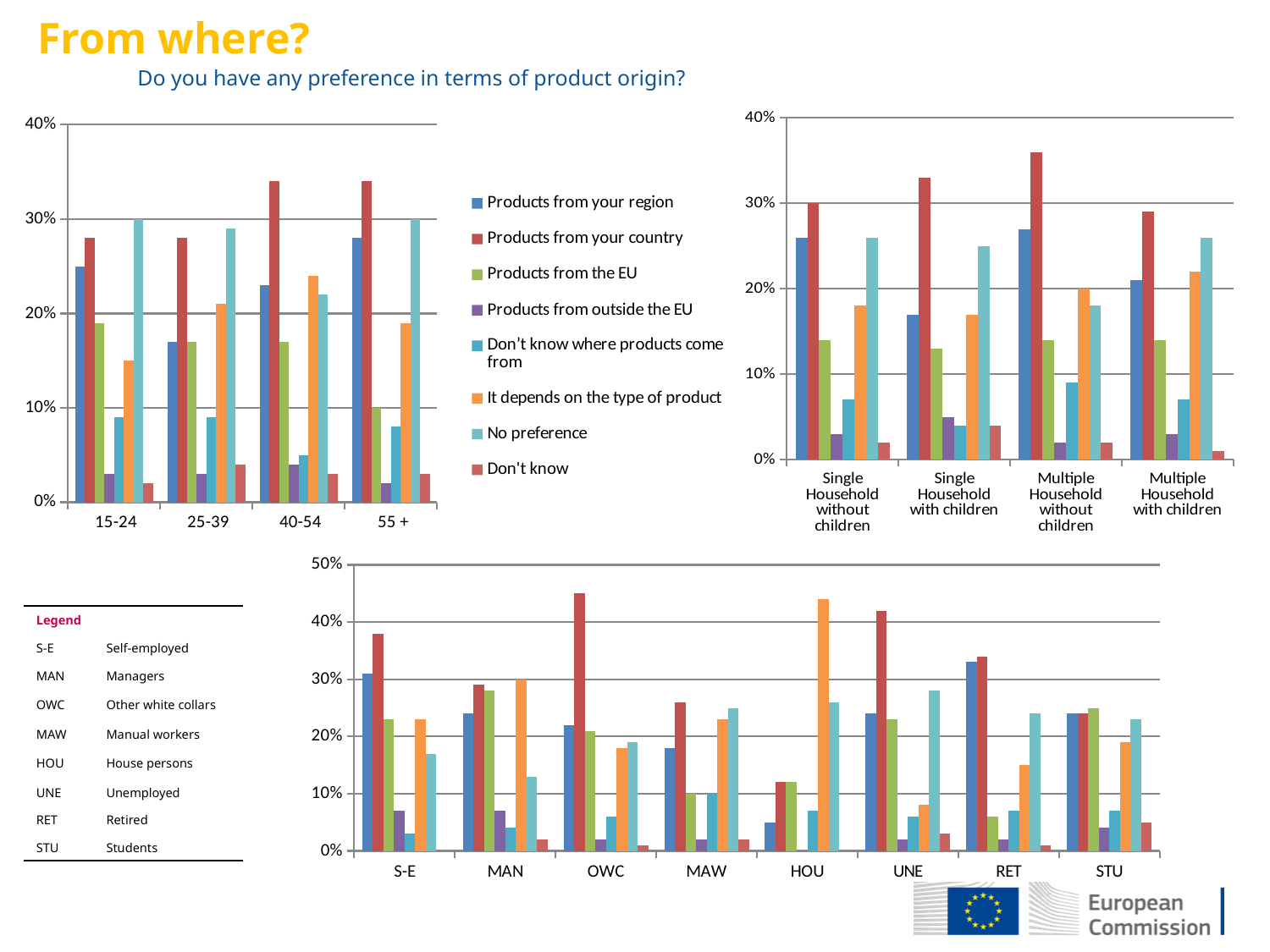
In the top-right household chart, which household type has the highest value for 'Products from your country'? Multiple Household without children In the bottom occupation chart, is the value for 'Products from your region' for HOU greater or less than 10%? less In the bottom occupation chart, which occupation has the highest value for 'Products from your country'? OWC How many household categories are shown on the x axis of the top-right chart? 4 According to the legend table on the slide, what does OWC stand for? Other white collars What kind of chart is the bottom chart with occupation categories (S-E, MAN, OWC, ...)? bar chart How many series does the legend in the middle of the slide list? 8 How many occupation categories are shown on the x axis of the bottom chart? 8 In the bottom occupation chart, is the value for 'It depends on the type of product' for HOU greater or less than 40%? greater In the top-right household chart, is the value for 'Products from your country' for Multiple Household without children greater or less than 30%? greater In the top-left age-group chart, for the 55 + group, which is larger: 'Products from your country' or 'Products from the EU'? Products from your country